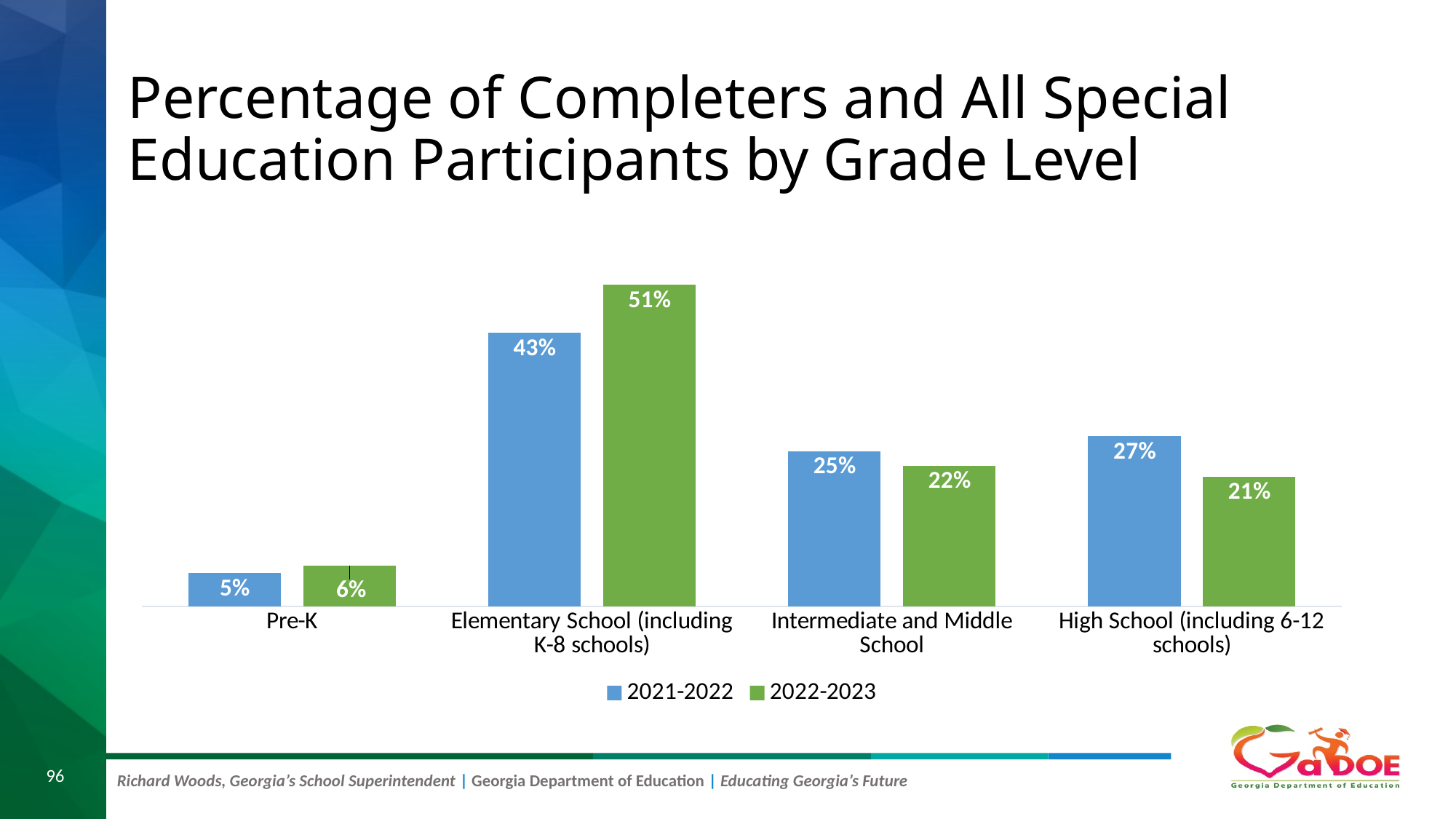
What kind of chart is shown on the slide? Bar chart What is the 2022-2023 value for High School (including 6-12 schools)? 21% How many grade-level categories are shown on the x axis? 4 What is the 2021-2022 value for Intermediate and Middle School? 25% Which grade level has the highest 2022-2023 value? Elementary School (including K-8 schools) Which colour represents the 2022-2023 series? Green What is the difference between the 2022-2023 and 2021-2022 values for Elementary School (including K-8 schools)? 8% What is the 2021-2022 value for Elementary School (including K-8 schools)? 43% Which is larger for High School (including 6-12 schools): the 2021-2022 value or the 2022-2023 value? 2021-2022 How many series does the legend list? 2 What is the 2022-2023 value for Pre-K? 6% Which grade level has the lowest 2021-2022 value? Pre-K